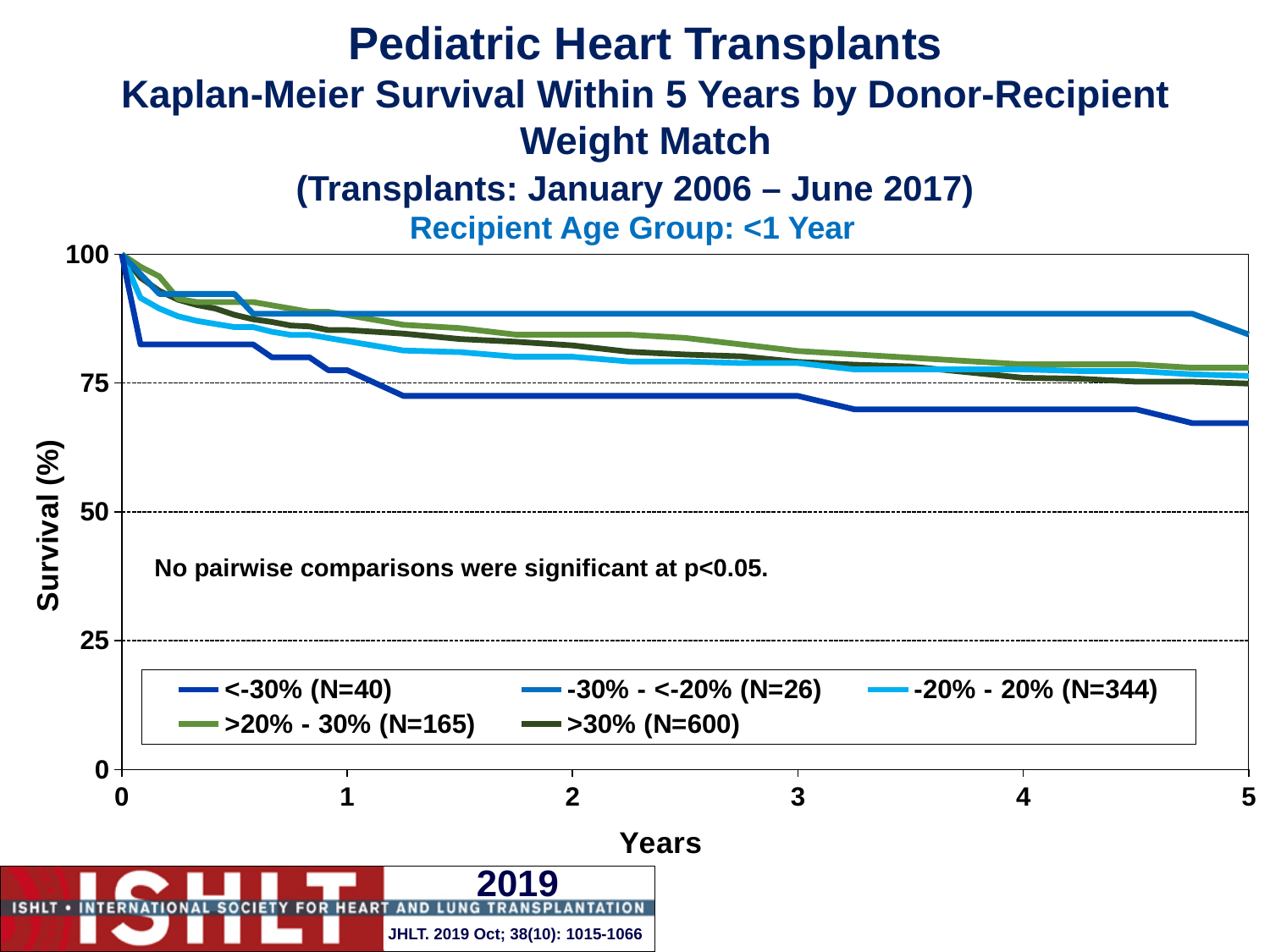
What is the N for the >30% weight match group in the legend? 600 What is the recipient age group shown in the chart subtitle? <1 Year Is the survival for the -30% - <-20% group at 3 years greater or less than 75? greater Which weight match group has the highest survival at 4 years? -30% - <-20% (N=26) Do the survival curves rise or fall as years increase? fall Is the survival for the >30% group at 1 year greater or less than 75? greater How many series does the legend list? 5 What kind of chart is shown on the slide? Line chart At 5 years, which is higher: survival for the <-30% group or the >20% - 30% group? >20% - 30% group Is the survival for the <-30% group at 5 years greater or less than 75? less What is the N for the -20% - 20% weight match group in the legend? 344 Which weight match group has the lowest survival at 5 years? <-30% (N=40)